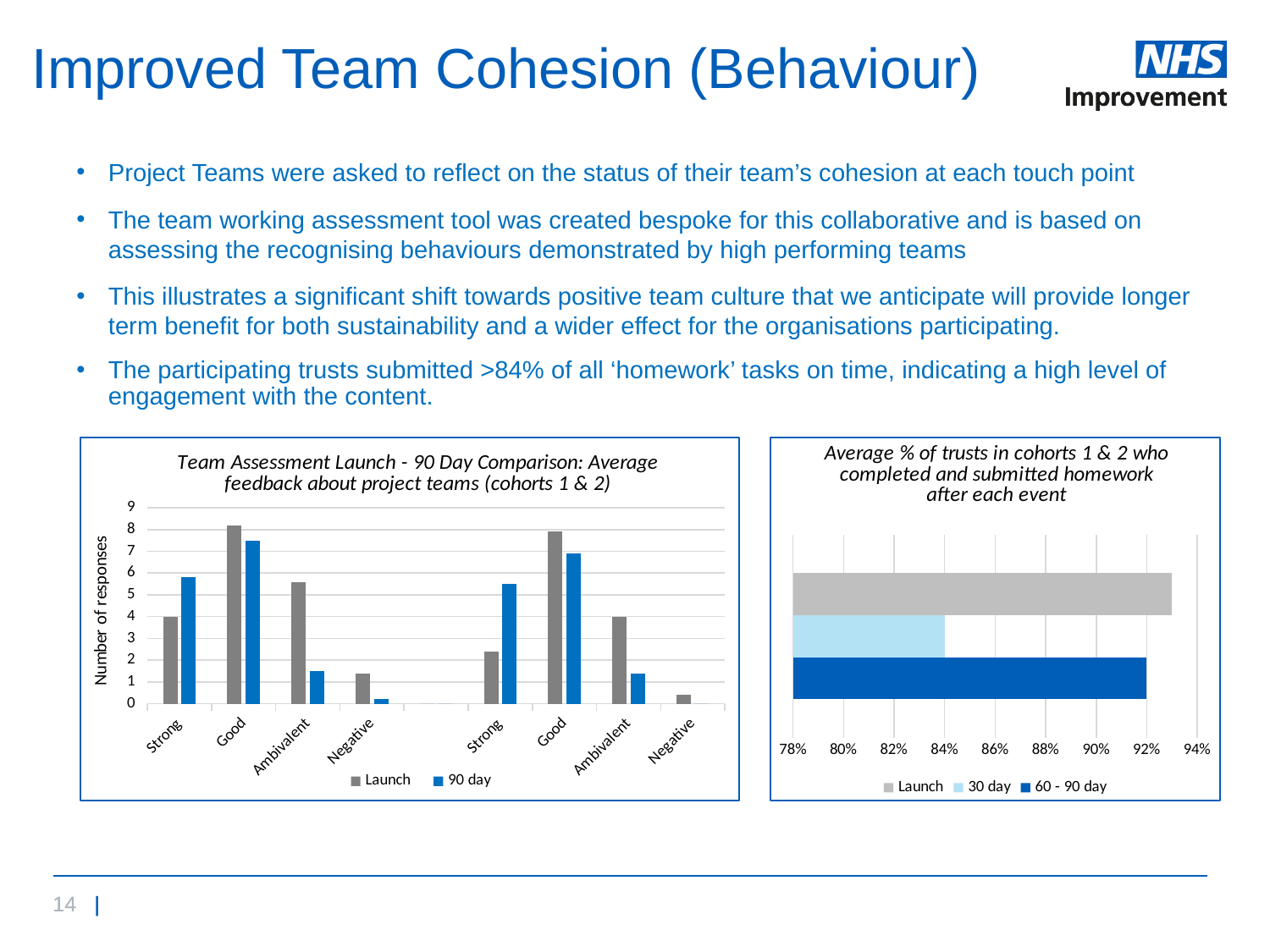
What kind of chart is the right-hand chart, 'Average % of trusts in cohorts 1 & 2 who completed and submitted homework after each event'? Bar chart In the right-hand chart, is the value for 30 day greater or less than 88%? less What is the y-axis title of the left-hand chart? Number of responses In the left-hand chart, is the 90 day value for the first (left-most) 'Ambivalent' category greater or less than 3? less How many series does the legend of the right-hand chart list? 3 What kind of chart is the left-hand chart, 'Team Assessment Launch - 90 Day Comparison'? Bar chart How many series does the legend of the left-hand chart list? 2 In the left-hand chart, for the second (right-hand) 'Ambivalent' category, which series is larger: Launch or 90 day? Launch In the left-hand chart, for the first (left-most) 'Strong' category, which series is larger: Launch or 90 day? 90 day In the right-hand chart, which series has the lowest value? 30 day In the right-hand chart, is the value for Launch greater or less than 90%? greater